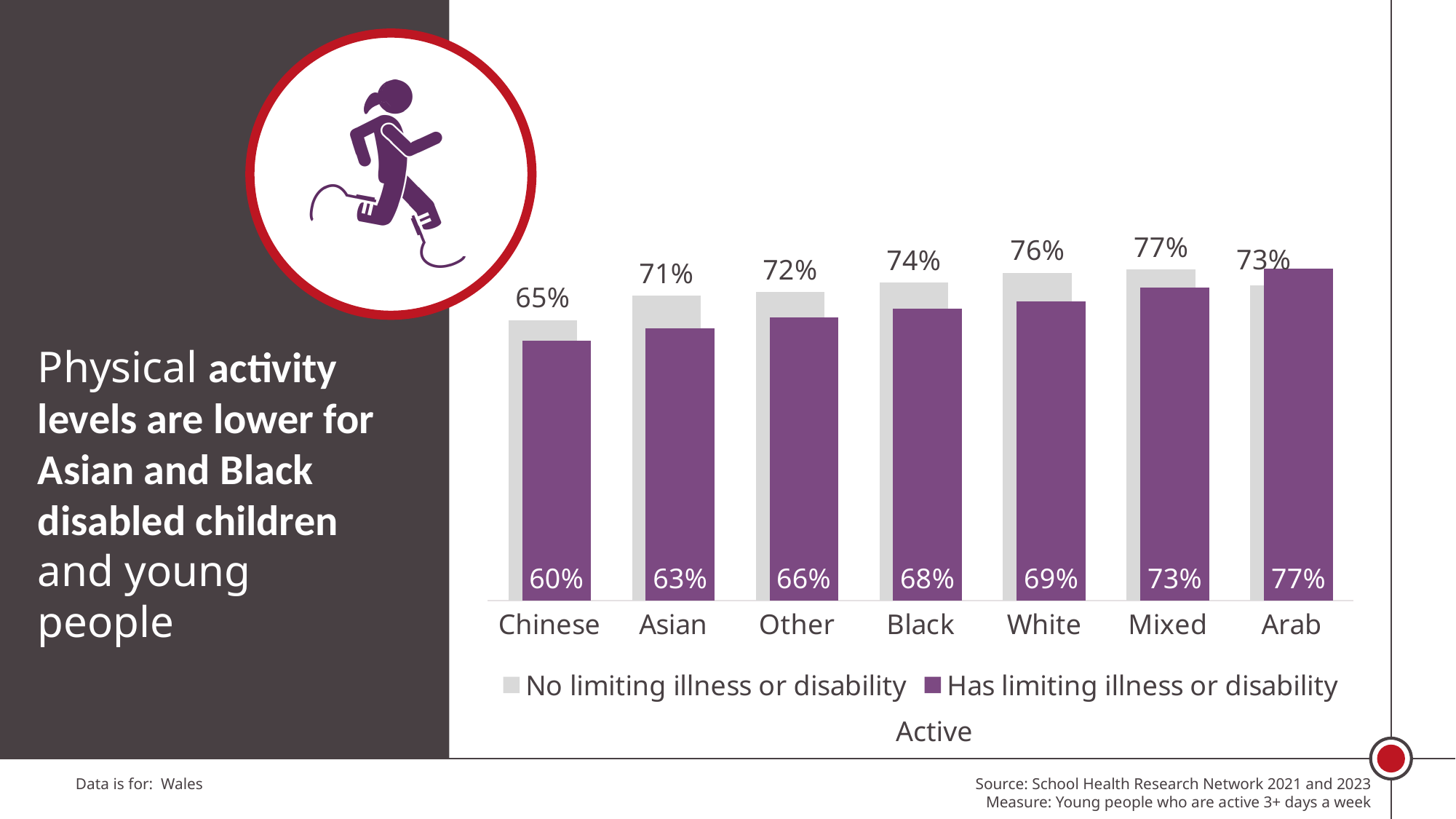
Which category has the highest value for the 'No limiting illness or disability' series? Mixed How many ethnic group categories are shown on the x axis? 7 How many series does the legend list? 2 Which category has the lowest value for the 'Has limiting illness or disability' series? Chinese For Arab young people, which series has the larger value: 'No limiting illness or disability' or 'Has limiting illness or disability'? Has limiting illness or disability What kind of chart is shown on the slide? Bar chart What is the value for Arab young people who have a limiting illness or disability? 77% What is the value for Black young people who have a limiting illness or disability? 68% What is the label shown below the legend on the chart? Active Which colour represents the 'Has limiting illness or disability' series? Purple What is the difference between the two series for Asian young people? 8 percentage points What is the value for Chinese young people with no limiting illness or disability? 65%